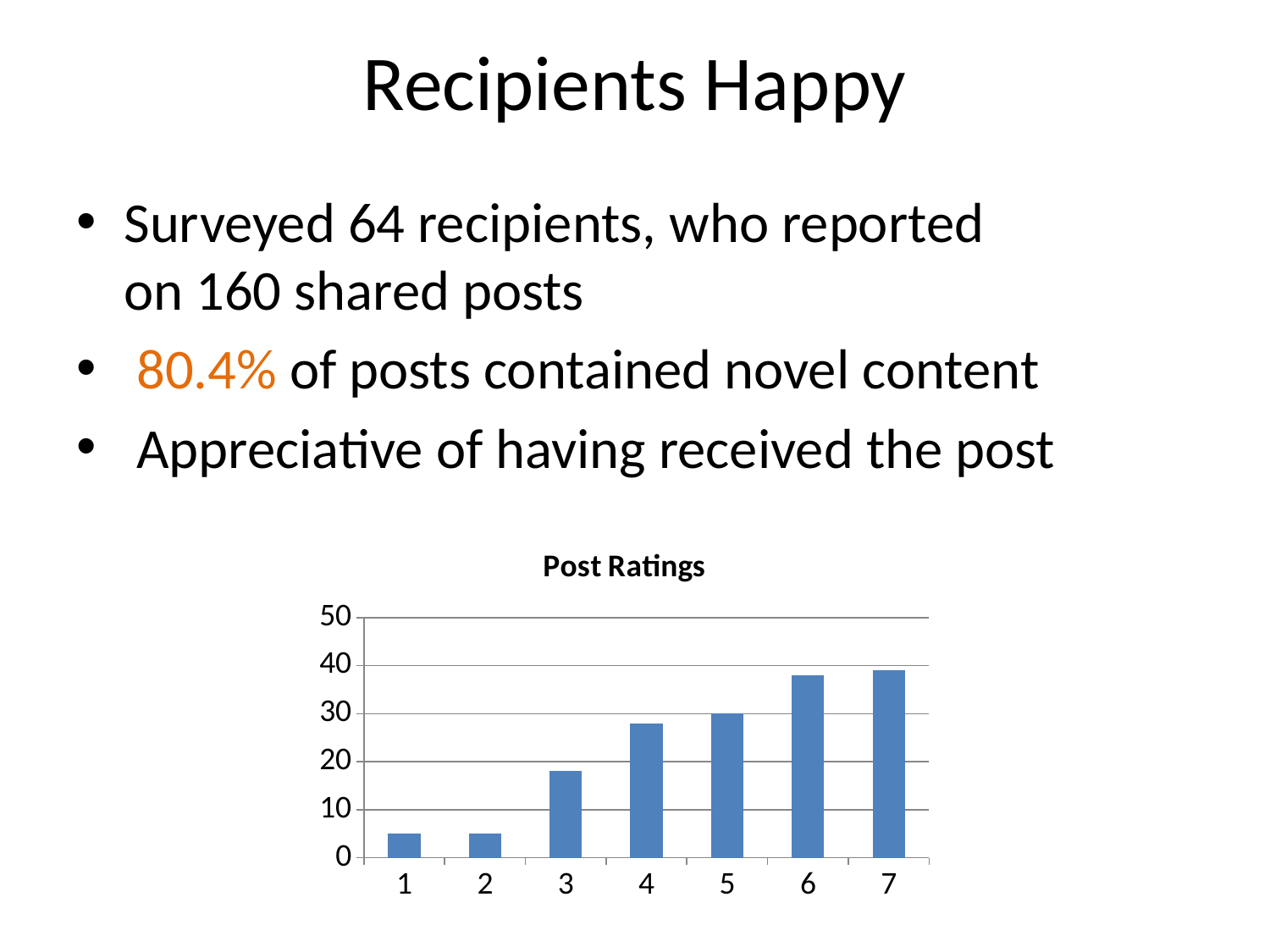
How many rating categories are shown on the x axis of the Post Ratings chart? 7 Which has the larger value, rating 3 or rating 4? rating 4 Is the value for rating 6 greater or less than 30? greater Do the values in the Post Ratings chart generally rise or fall from rating 1 to rating 7? rise What kind of chart is shown on the slide? bar chart What is the title of the chart? Post Ratings Is the value for rating 3 greater or less than 20? less Is the value for rating 4 greater or less than 20? greater Which has the larger value, rating 1 or rating 6? rating 6 What is the highest value shown on the y axis of the Post Ratings chart? 50